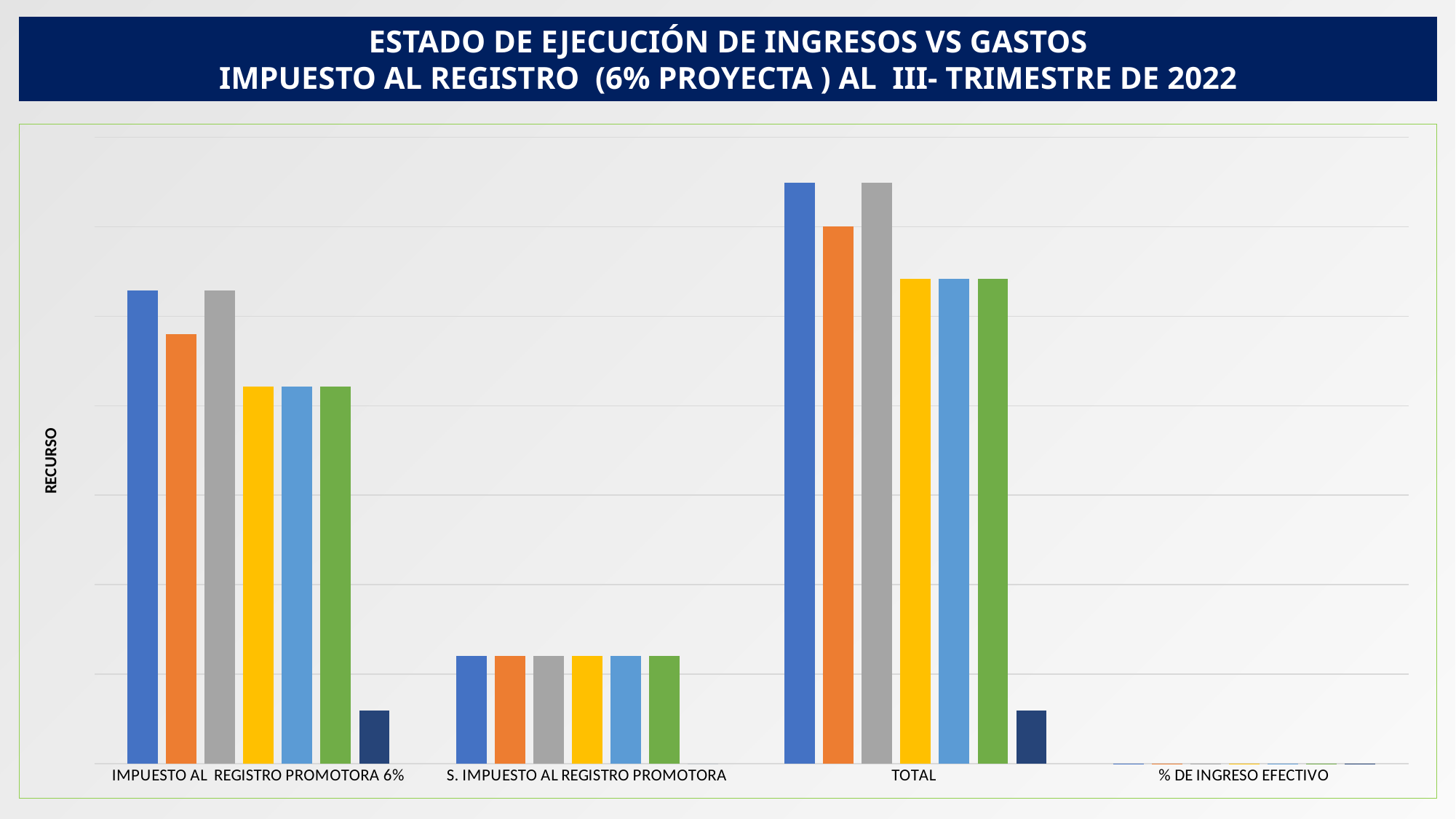
What is the title shown above the chart? ESTADO DE EJECUCIÓN DE INGRESOS VS GASTOS IMPUESTO AL REGISTRO (6% PROYECTA ) AL III- TRIMESTRE DE 2022 What is the label on the vertical axis of the chart? RECURSO What kind of chart is shown on the slide? bar chart How many categories are shown on the x axis of the chart? 4 In the IMPUESTO AL REGISTRO PROMOTORA 6% category, which bar is taller, the blue bar or the orange bar? the blue bar In the TOTAL category, which bar is taller, the orange bar or the yellow bar? the orange bar Which category on the x axis has the lowest bars? % DE INGRESO EFECTIVO Which category has taller bars, IMPUESTO AL REGISTRO PROMOTORA 6% or S. IMPUESTO AL REGISTRO PROMOTORA? IMPUESTO AL REGISTRO PROMOTORA 6% Which category on the x axis has the tallest bars? TOTAL What is the label of the third category on the x axis? TOTAL